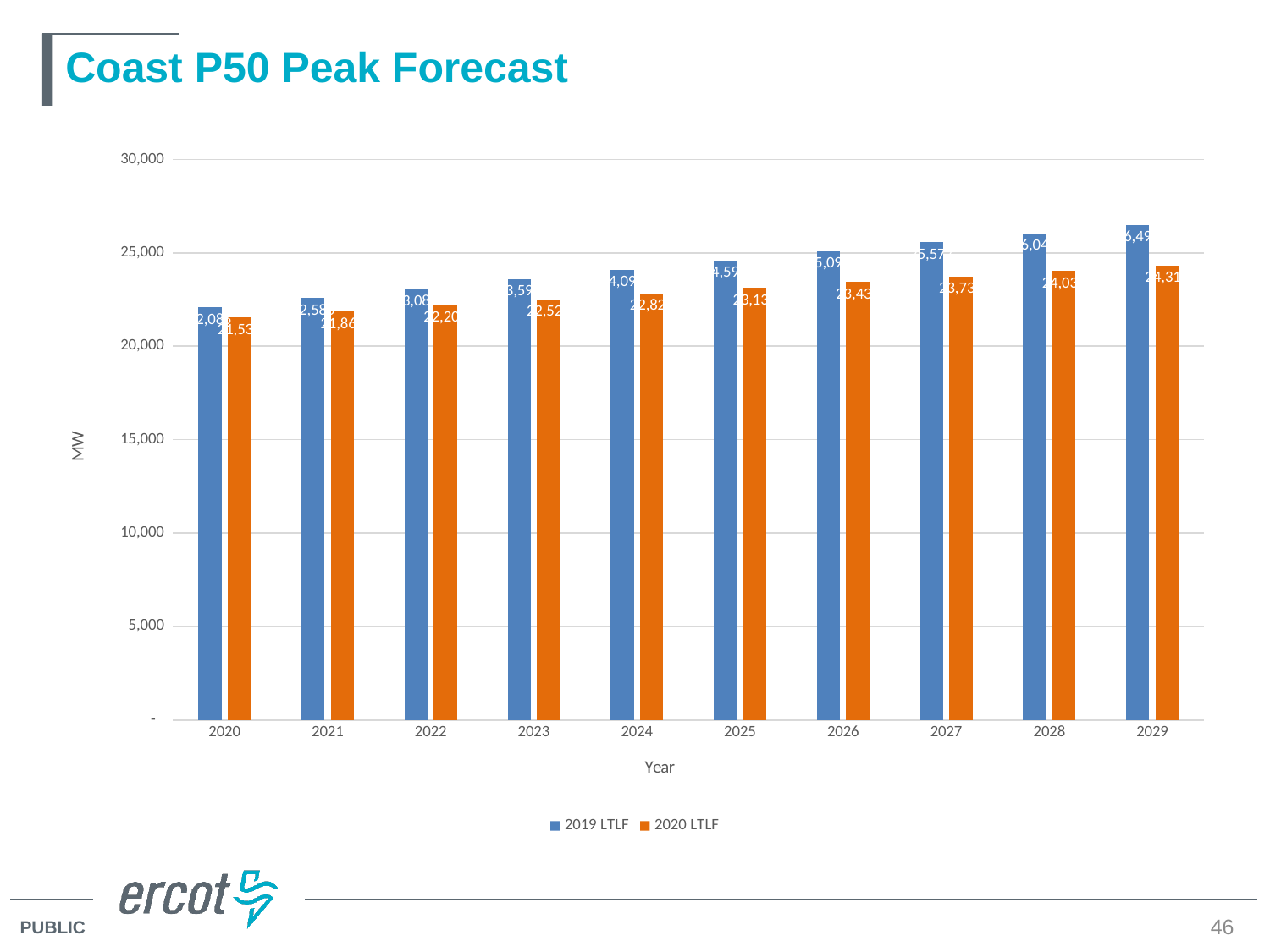
How many years are shown on the x axis? 10 In 2029, which series has the larger value, 2019 LTLF or 2020 LTLF? 2019 LTLF Is the 2020 LTLF value for 2020 greater or less than 20,000? greater What is the title of the chart? Coast P50 Peak Forecast What is the label on the y axis? MW Is the 2020 LTLF value for 2029 greater or less than 25,000? less What kind of chart is shown on the slide? bar chart How many series does the legend list? 2 Which year has the lowest 2020 LTLF value? 2020 Which year has the highest 2019 LTLF value? 2029 Is the 2019 LTLF value for 2029 greater or less than 25,000? greater Do the 2020 LTLF values rise or fall from 2020 to 2029? rise